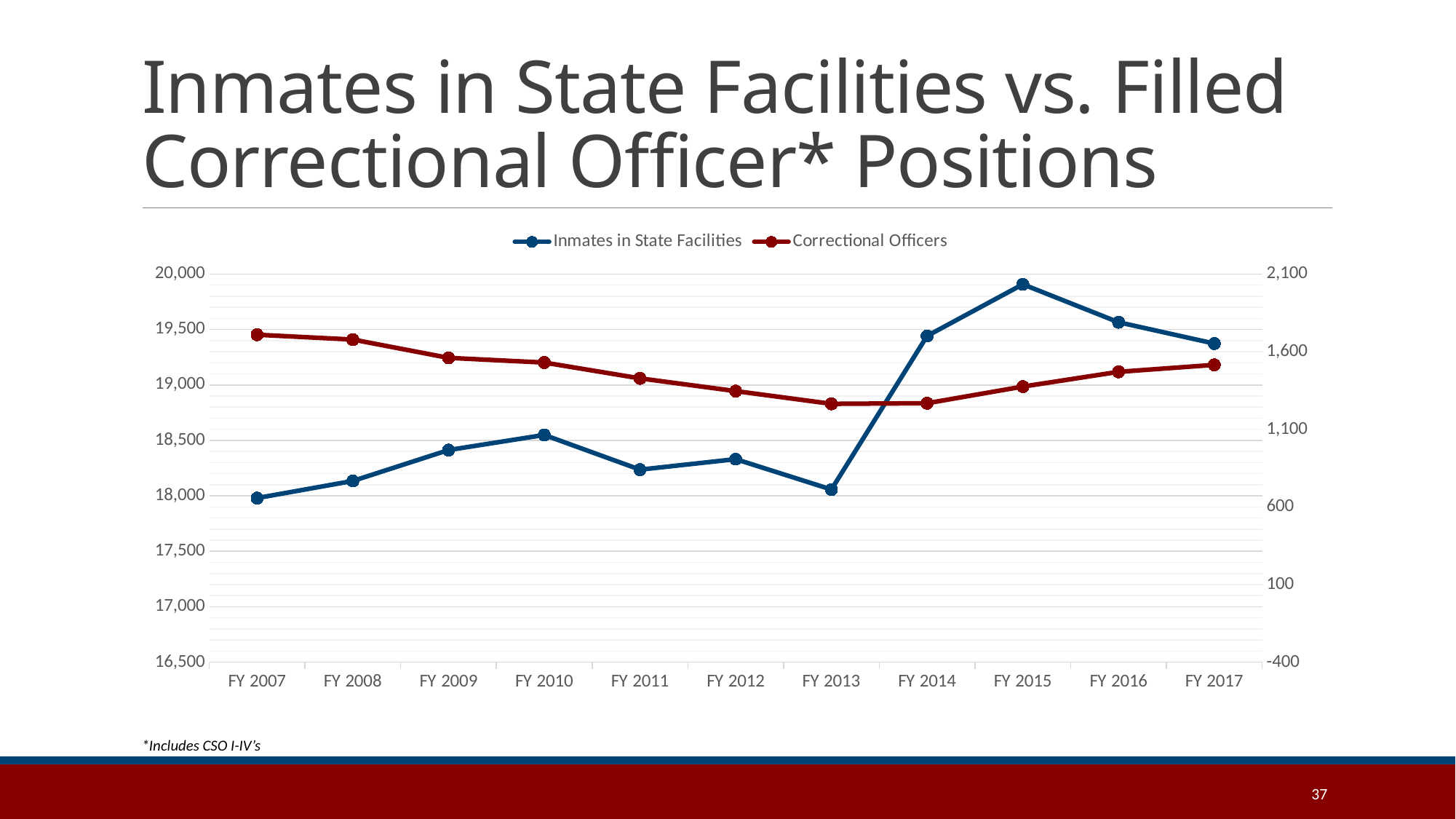
How many fiscal years are plotted along the x axis? 11 How many series does the legend list? 2 Is the value for Inmates in State Facilities in FY 2015 greater or less than 19,500? greater Does the Correctional Officers series rise or fall from FY 2007 to FY 2013? Fall Does the Inmates in State Facilities series rise or fall from FY 2013 to FY 2015? Rise What colour is the line for Correctional Officers? Dark red Which is larger for Inmates in State Facilities: FY 2010 or FY 2011? FY 2010 In which fiscal year is the Inmates in State Facilities series at its highest? FY 2015 Is the value for Correctional Officers in FY 2007 greater or less than 1,600 on the right axis? greater What kind of chart is shown on the slide? Line chart Is the value for Inmates in State Facilities in FY 2013 greater or less than 18,500? less